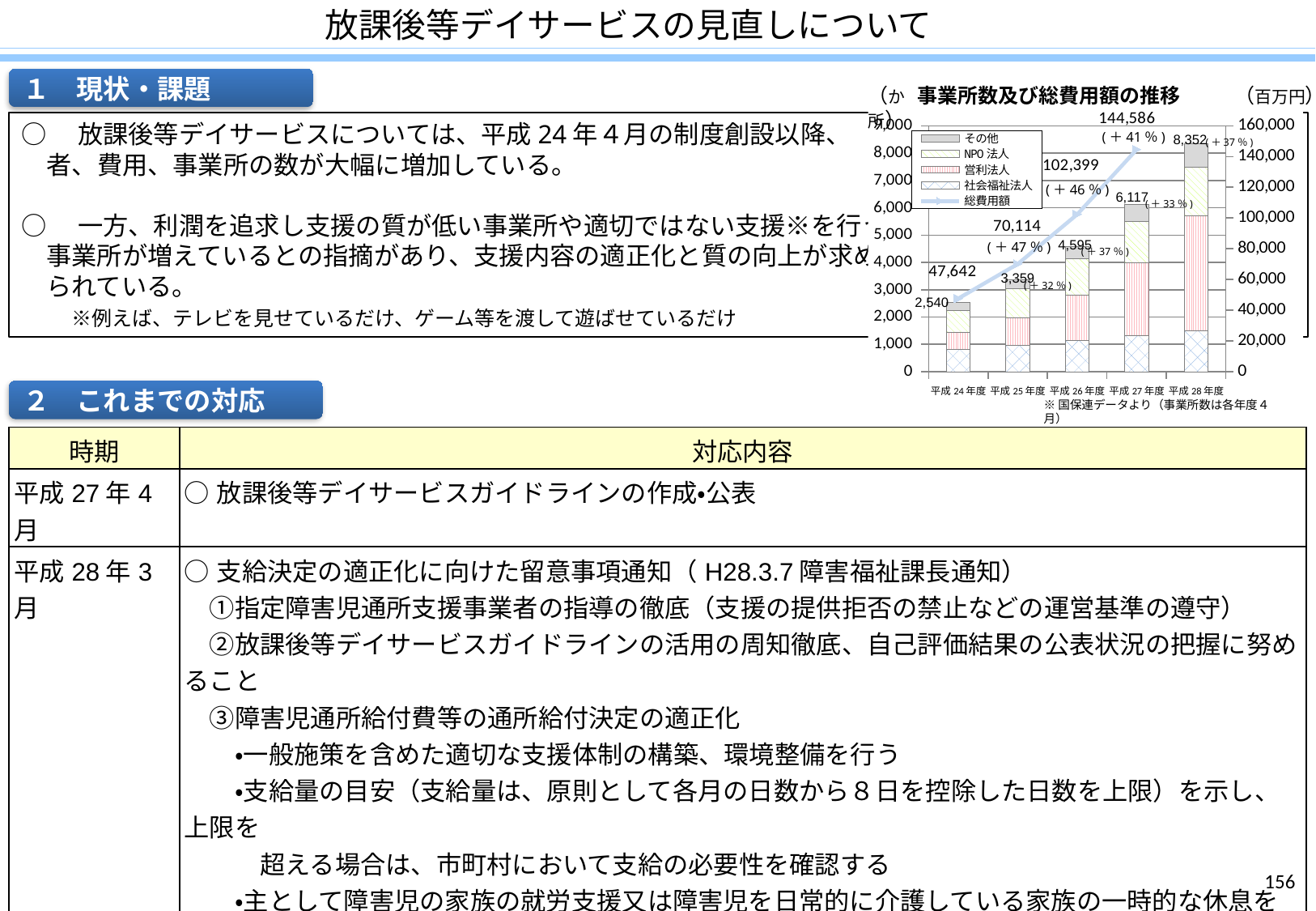
How many series does the chart's legend list? 5 Which fiscal year has the lowest total cost (総費用額) shown? 平成24年度 Which fiscal year has the highest total number of establishments? 平成28年度 What is the total number of establishments (事業所数) shown for 平成28年度? 8,352 What is the title of the chart on the slide? 事業所数及び総費用額の推移 What percentage increase in total cost (総費用額) is labelled for 平成25年度? ＋47％ What is the total number of establishments (事業所数) shown for 平成24年度? 2,540 What is the total cost (総費用額) shown for 平成26年度? 102,399 Does the total number of establishments rise or fall from 平成24年度 to 平成28年度? rise What is the total cost (総費用額) shown for 平成27年度? 144,586 What is the difference in the total number of establishments between 平成28年度 and 平成27年度? 2,235 How many fiscal years (categories) are shown on the x axis of the chart? 5